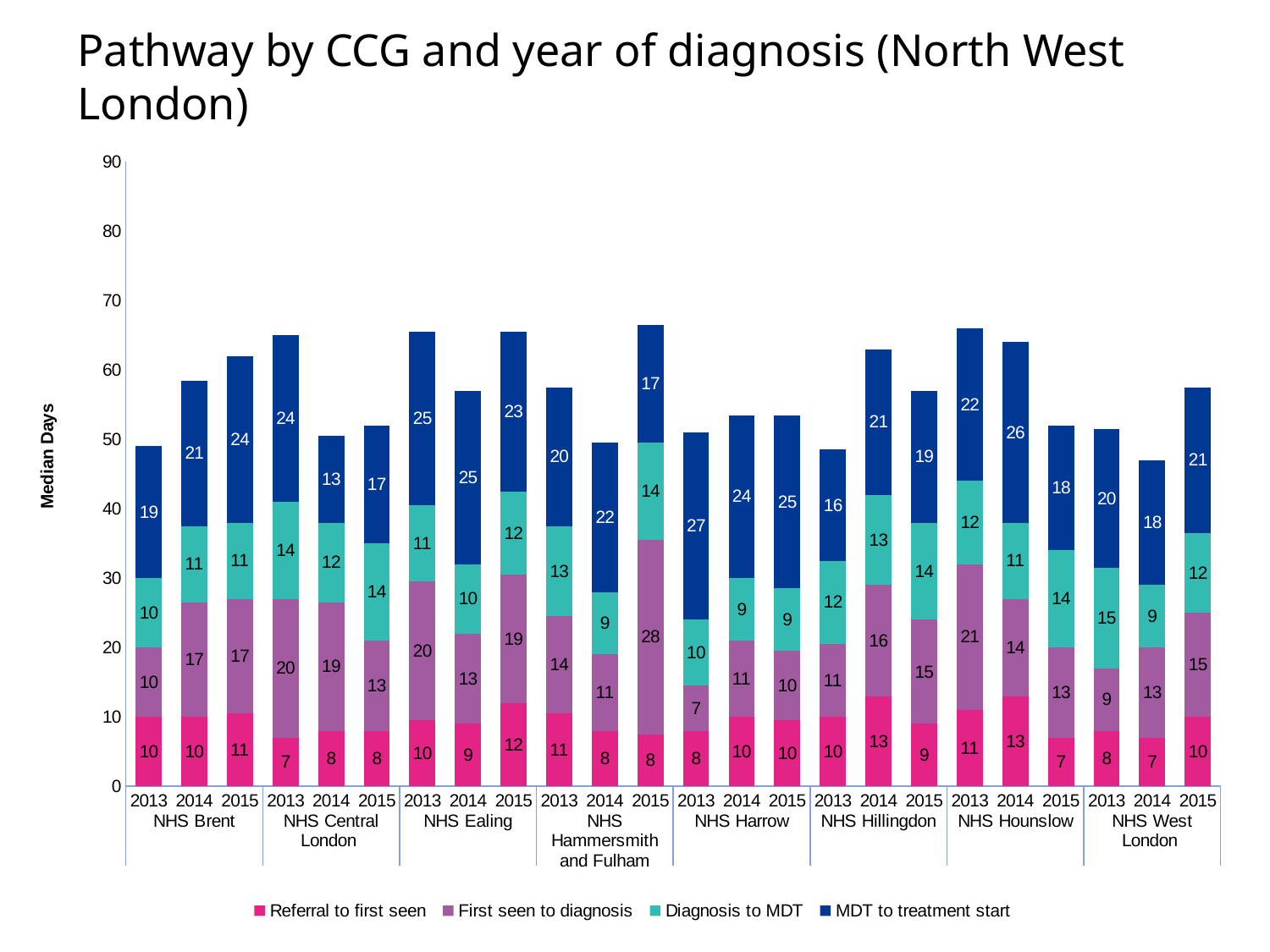
What kind of chart is shown on the slide? Stacked bar chart What is the value of 'Referral to first seen' for NHS Hillingdon in 2014? 13 What is the total median days for the NHS Brent 2013 bar? 49 How many series does the legend list? 4 What is the difference between the 'MDT to treatment start' values for NHS Hounslow 2014 and NHS Hounslow 2015? 8 How many bars are plotted in the chart? 24 Which is larger: 'Diagnosis to MDT' for NHS West London 2013 or for NHS West London 2014? NHS West London 2013 What is the label on the vertical axis? Median Days What is the value of 'First seen to diagnosis' for NHS Hammersmith and Fulham in 2015? 28 Is the total height of the NHS Ealing 2013 bar greater or less than 60? greater What is the value of 'MDT to treatment start' for NHS Harrow in 2013? 27 Which bar has the highest 'MDT to treatment start' value? NHS Harrow 2013